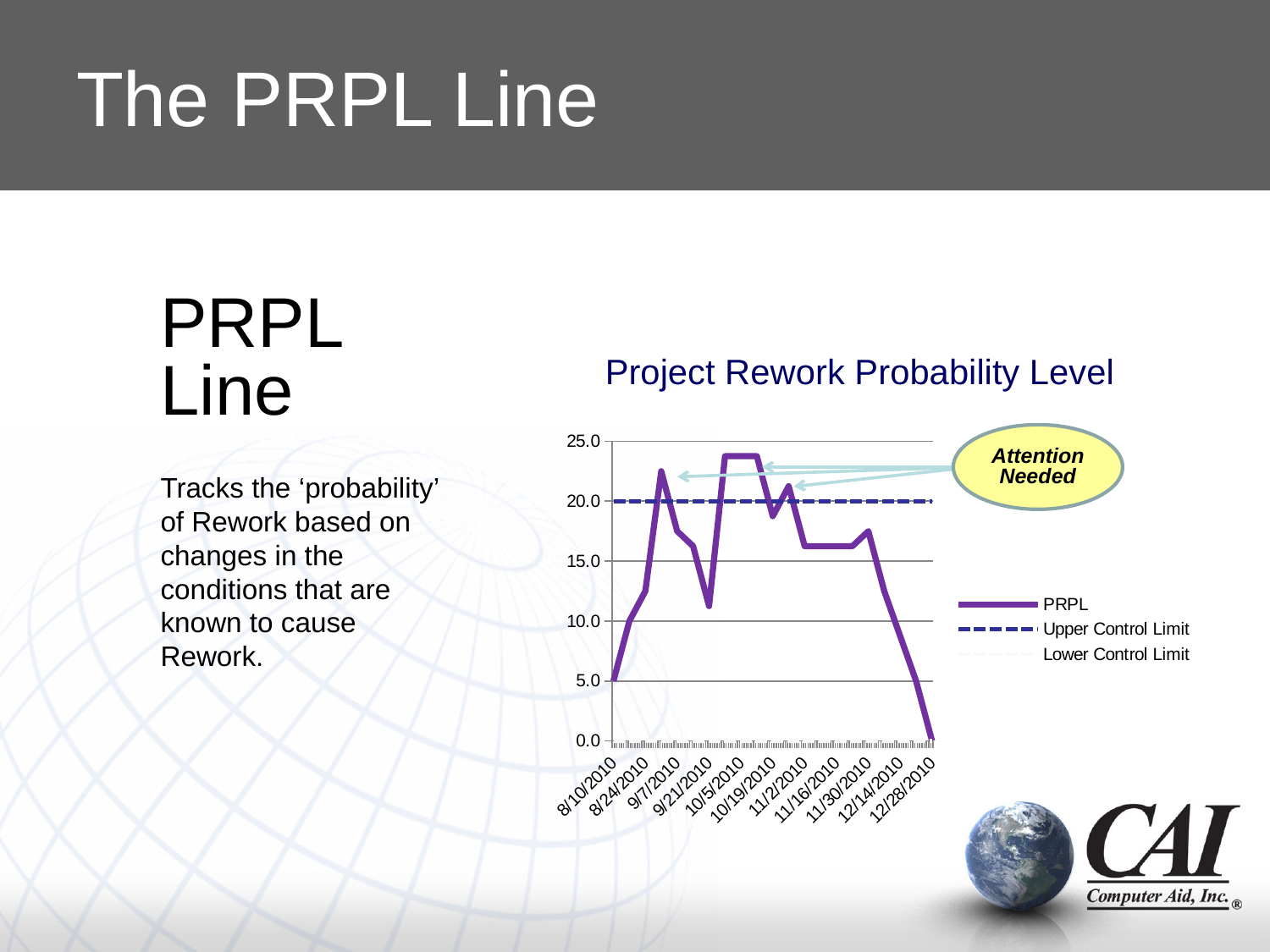
How many series does the chart legend list? 3 What does the yellow callout next to the chart say? Attention Needed Is the PRPL value around 11/16/2010 greater or less than 15.0? greater Does the PRPL line rise or fall between 11/30/2010 and 12/28/2010? falls What is the PRPL value on 12/28/2010, the last date on the x axis? 0.0 What is the PRPL value on 8/10/2010, the first date on the x axis? 5.0 Is the PRPL value around 11/16/2010 greater or less than 20.0? less What kind of chart is shown on the slide? line chart What value does the Upper Control Limit line sit at? 20.0 What is the title of the chart? Project Rework Probability Level How many date labels are shown on the x axis? 11